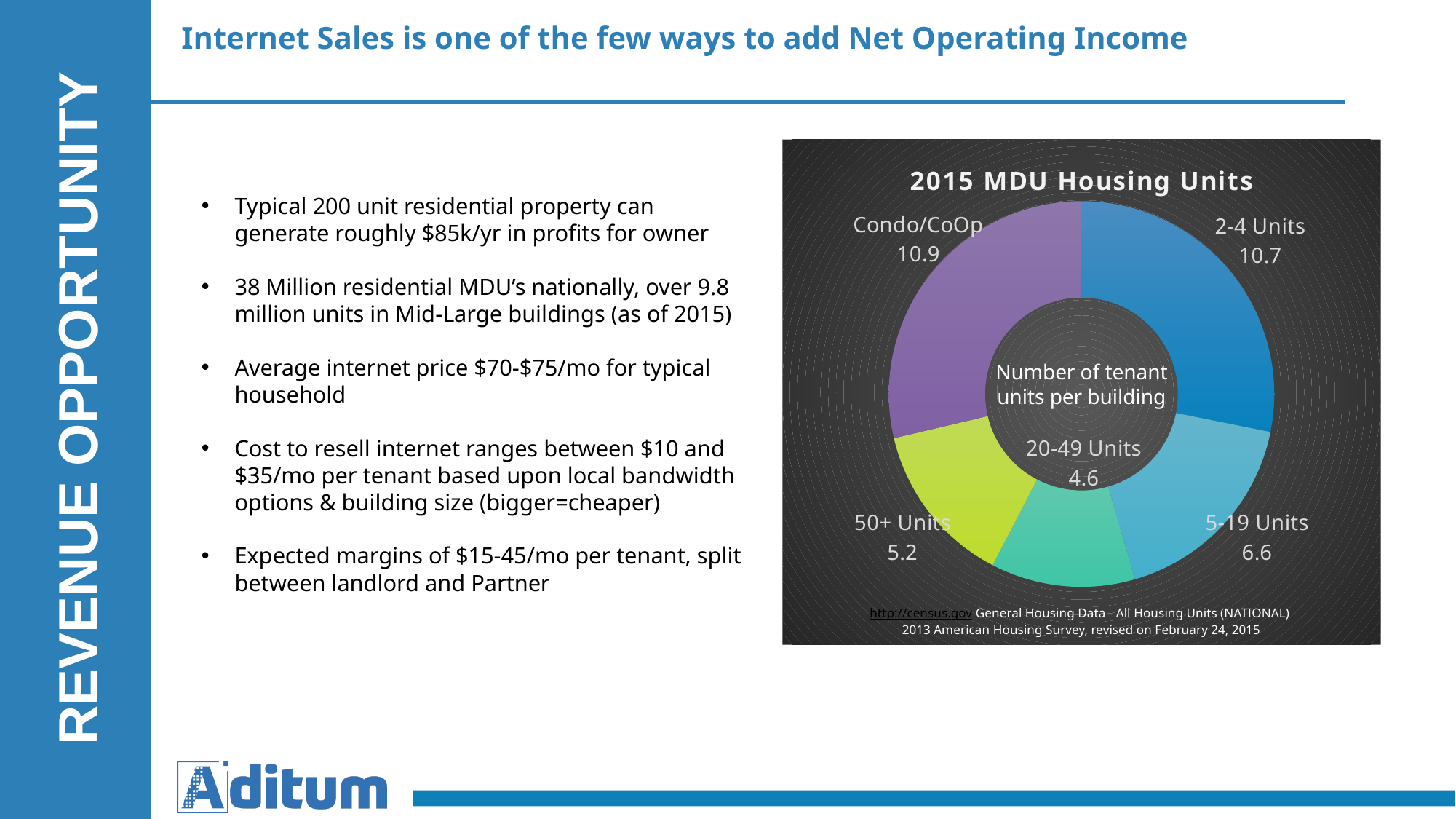
What is the difference between the values for 5-19 Units and 50+ Units? 1.4 Which category has the smallest value in the chart? 20-49 Units What type of chart is shown on the slide? Doughnut (pie) chart Which is larger, the value for 50+ Units or the value for 20-49 Units? 50+ Units What text appears in the centre of the doughnut chart? Number of tenant units per building What is the value for 20-49 Units in the chart? 4.6 What is the title of the chart? 2015 MDU Housing Units How many categories are shown in the chart? 5 Which category has the largest value in the chart? Condo/CoOp What is the value for 5-19 Units in the chart? 6.6 What is the value for Condo/CoOp in the 2015 MDU Housing Units chart? 10.9 What is the value for 2-4 Units in the chart? 10.7